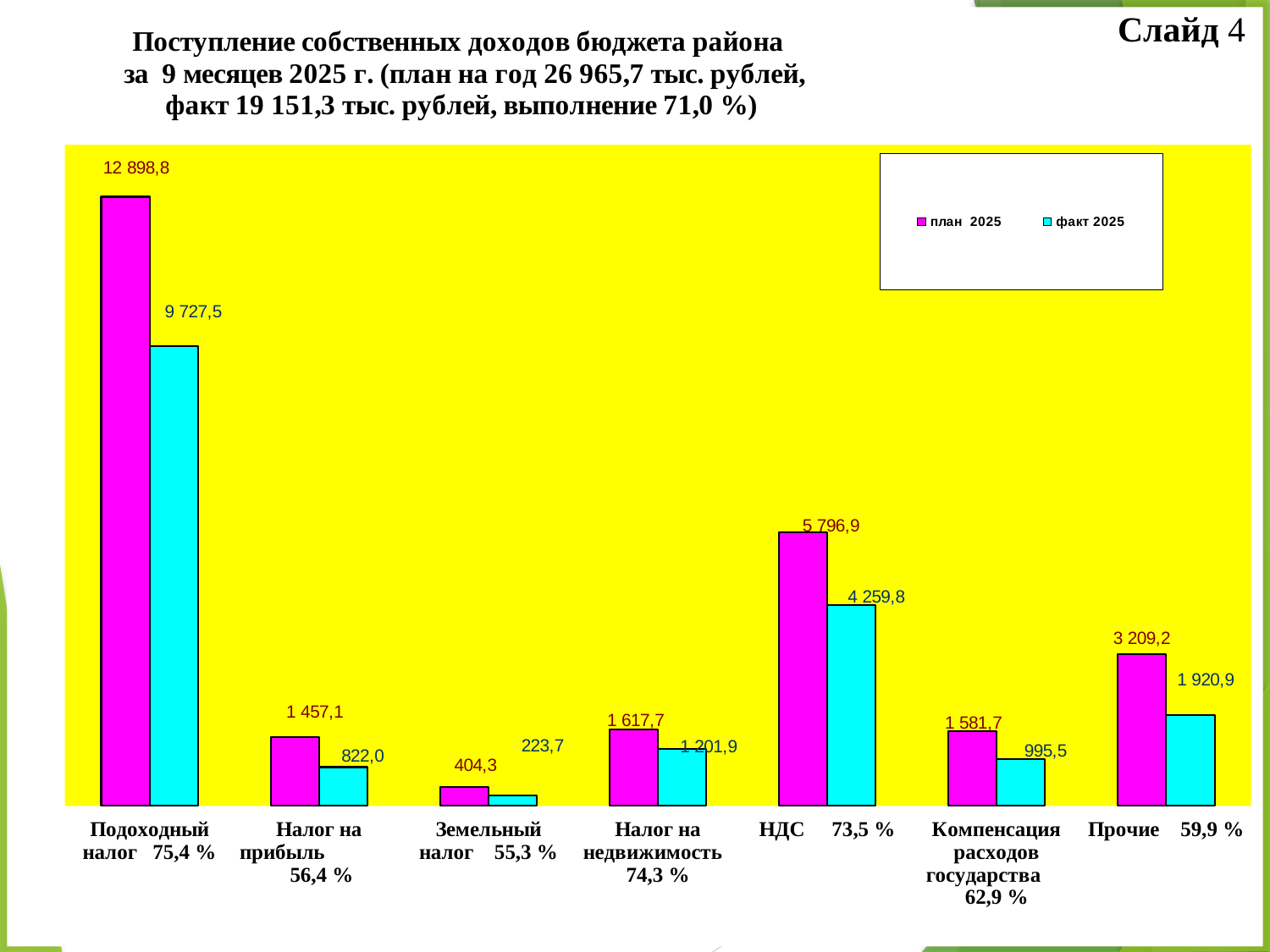
What kind of chart is shown on the slide? Bar chart What is the факт 2025 value for Земельный налог? 223,7 What is the план 2025 value for Прочие? 3 209,2 Which is larger: the факт 2025 value for Налог на недвижимость or the факт 2025 value for Компенсация расходов государства? Налог на недвижимость What is the план 2025 value for Подоходный налог? 12 898,8 What is the difference between the план 2025 and факт 2025 values for НДС? 1 537,1 Which category has the highest факт 2025 value? Подоходный налог How many series does the legend list? 2 Which category has the lowest план 2025 value? Земельный налог What is the difference between the план 2025 and факт 2025 values for Подоходный налог? 3 171,3 How many categories are shown on the x axis of the chart? 7 What is the факт 2025 value for НДС? 4 259,8